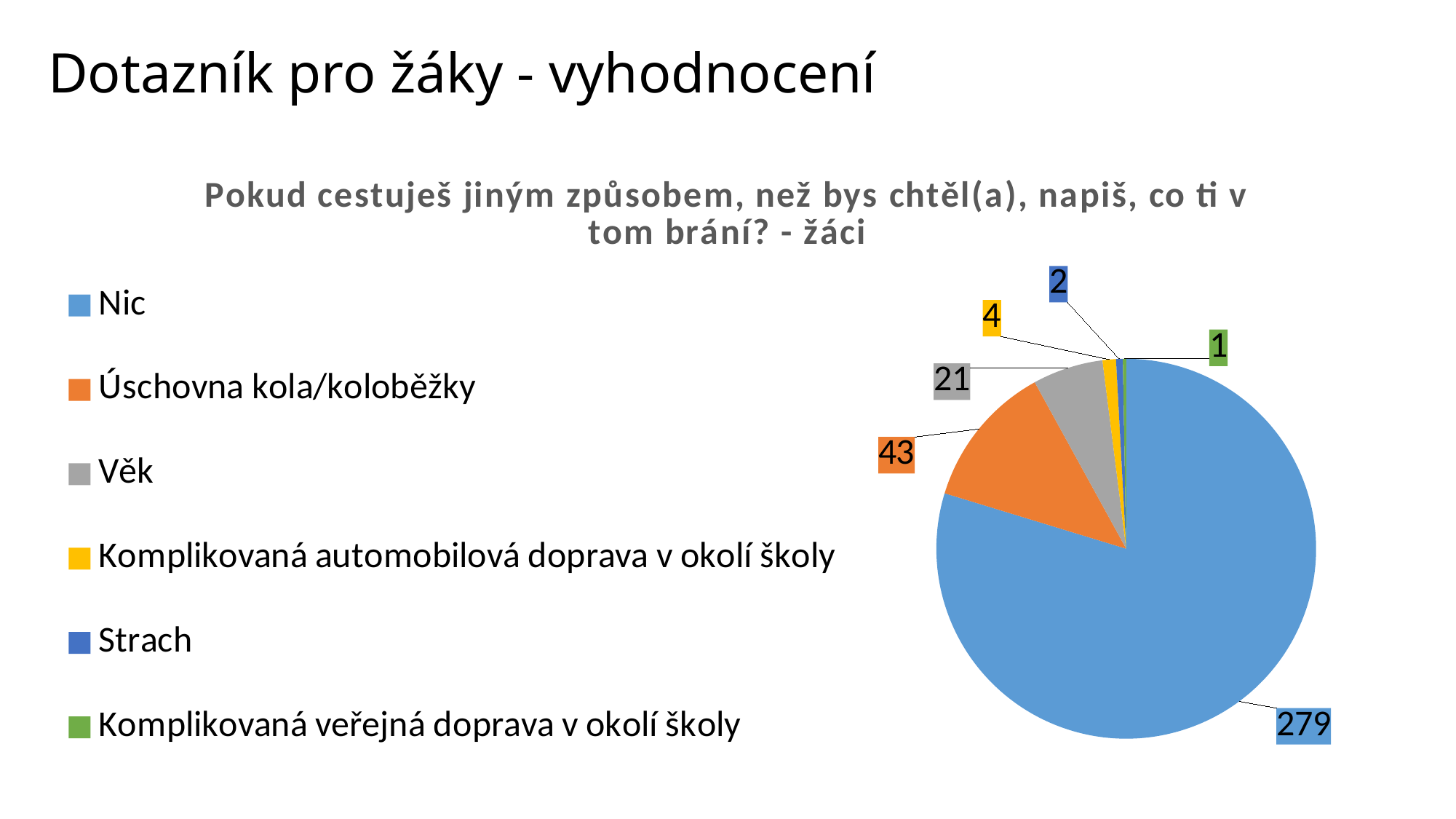
Which is larger, the value for Komplikovaná automobilová doprava v okolí školy or the value for Strach? Komplikovaná automobilová doprava v okolí školy What is the value for Nic? 279 What is the difference between the values for Úschovna kola/koloběžky and Věk? 22 What is the title of the chart? Pokud cestuješ jiným způsobem, než bys chtěl(a), napiš, co ti v tom brání? - žáci How many categories does the pie chart have? 6 What is the value for Strach? 2 Which category has the largest slice? Nic What is the value for Věk? 21 What is the value for Úschovna kola/koloběžky? 43 What is the value for Komplikovaná veřejná doprava v okolí školy? 1 Which category has the smallest slice? Komplikovaná veřejná doprava v okolí školy What kind of chart is shown on the slide? pie chart